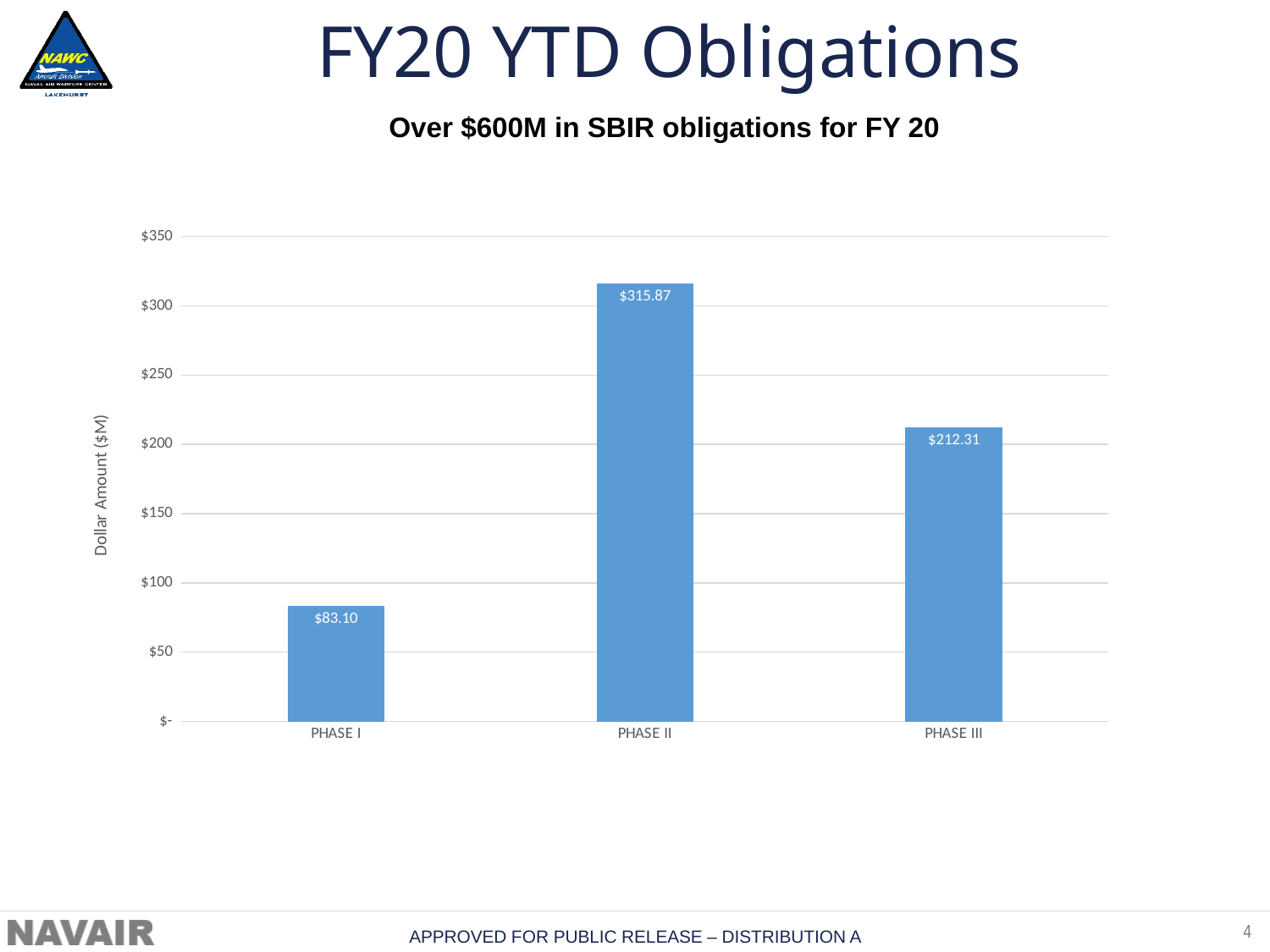
What kind of chart is shown on the slide? bar chart What is the label of the vertical axis? Dollar Amount ($M) What is the value for PHASE I? $83.10 Which phase has the highest obligations? PHASE II What is the difference between the values for PHASE II and PHASE III? $103.56 How many phases are shown on the chart? 3 Is the value for PHASE II greater or less than $300? greater What is the difference between the values for PHASE III and PHASE I? $129.21 Which is larger, the value for PHASE I or the value for PHASE III? PHASE III Which phase has the lowest obligations? PHASE I What is the value for PHASE II? $315.87 What is the value for PHASE III? $212.31